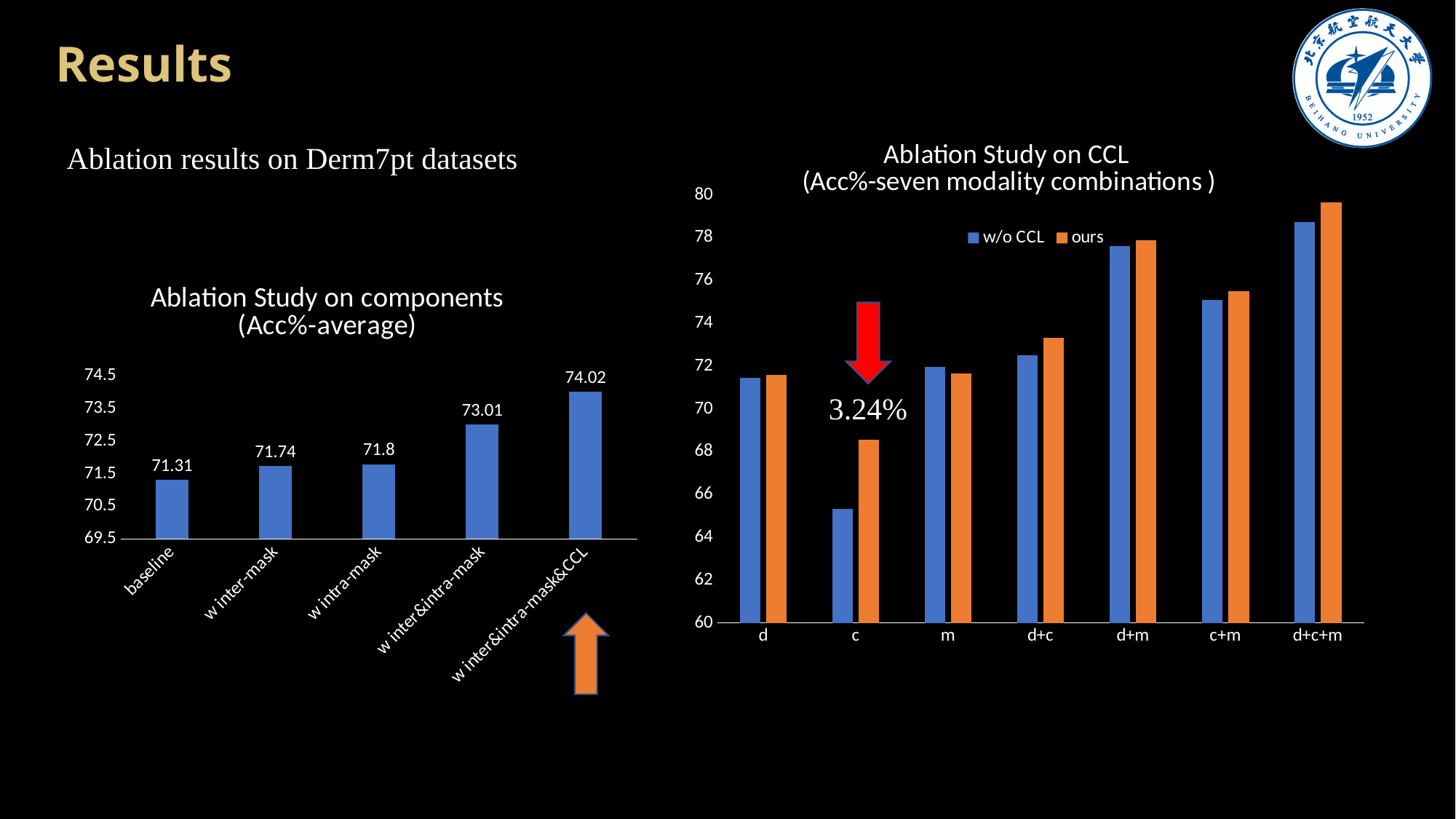
In the 'Ablation Study on components' chart, how many categories are shown? 5 In the 'Ablation Study on CCL' chart, is the w/o CCL value for c greater or less than 66? less In the 'Ablation Study on CCL' chart, how many modality combinations are shown on the x axis? 7 In the 'Ablation Study on CCL' chart, how many series does the legend list? 2 In the 'Ablation Study on components' chart, do the values rise or fall from left to right? rise In the 'Ablation Study on components' chart, which category has the highest value? w inter&intra-mask&CCL In the 'Ablation Study on components' chart, what is the value for baseline? 71.31 In the 'Ablation Study on components' chart, which category has the lowest value? baseline In the 'Ablation Study on components' chart, what is the difference between w inter&intra-mask&CCL and baseline? 2.71 What kind of chart is the 'Ablation Study on CCL' chart? bar chart In the 'Ablation Study on CCL' chart, which series has the larger value for d+c+m, w/o CCL or ours? ours In the 'Ablation Study on components' chart, what is the value for w inter&intra-mask? 73.01